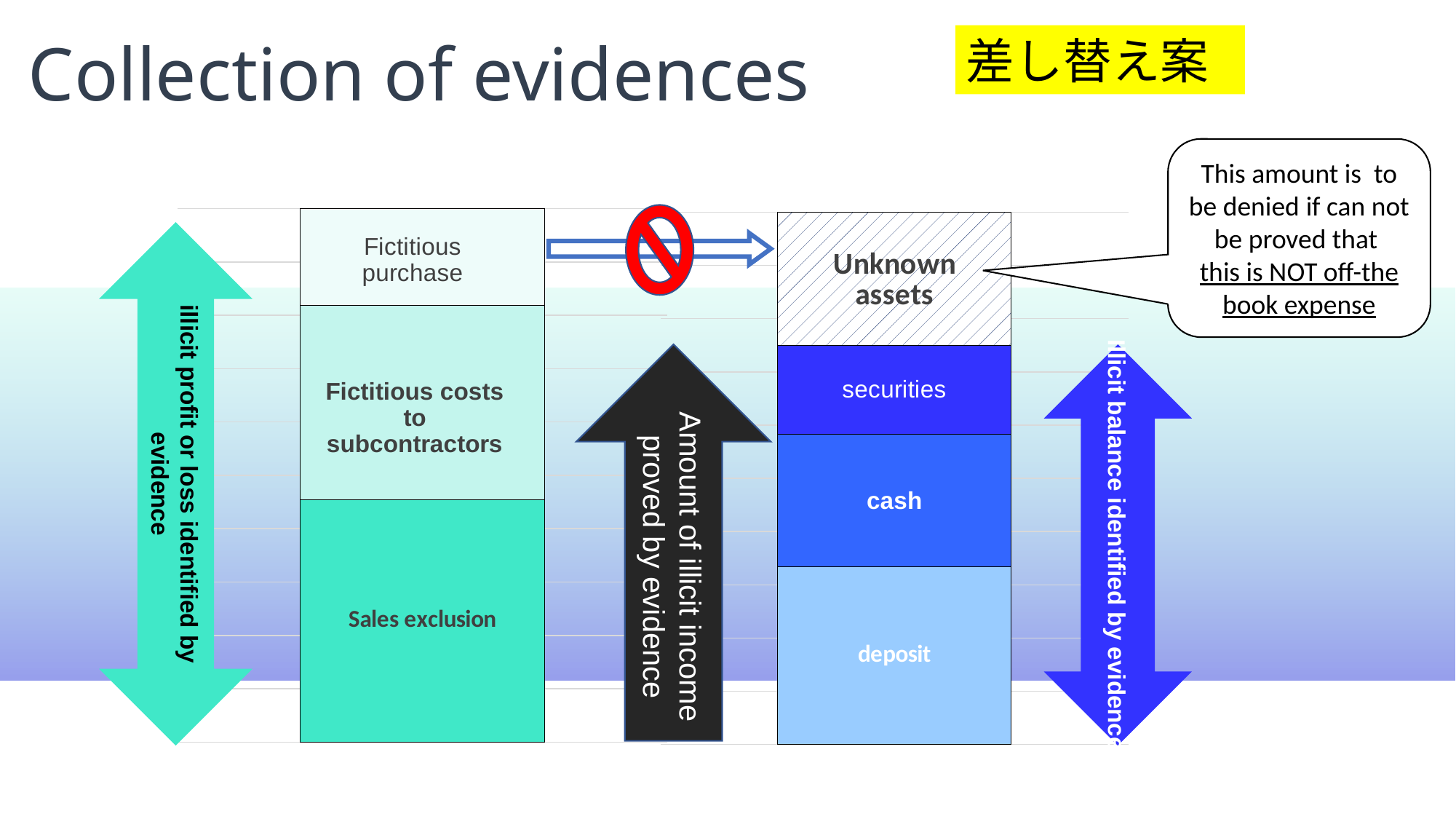
Which segment of the right stacked bar is drawn with a hatched pattern? Unknown assets What kind of chart is shown on the slide? Stacked bar chart In the right stacked bar, which segment is the smallest? securities What is the title of the slide containing the chart? Collection of evidences How many segments make up the right stacked bar? 4 How many segments make up the left stacked bar? 3 In the left stacked bar, which segment is the largest? Sales exclusion In the left stacked bar, which segment is the smallest? Fictitious purchase In the right stacked bar, which is larger: securities or deposit? deposit In the left stacked bar, which is larger: Fictitious purchase or Sales exclusion? Sales exclusion In the right stacked bar, which segment is the largest? deposit